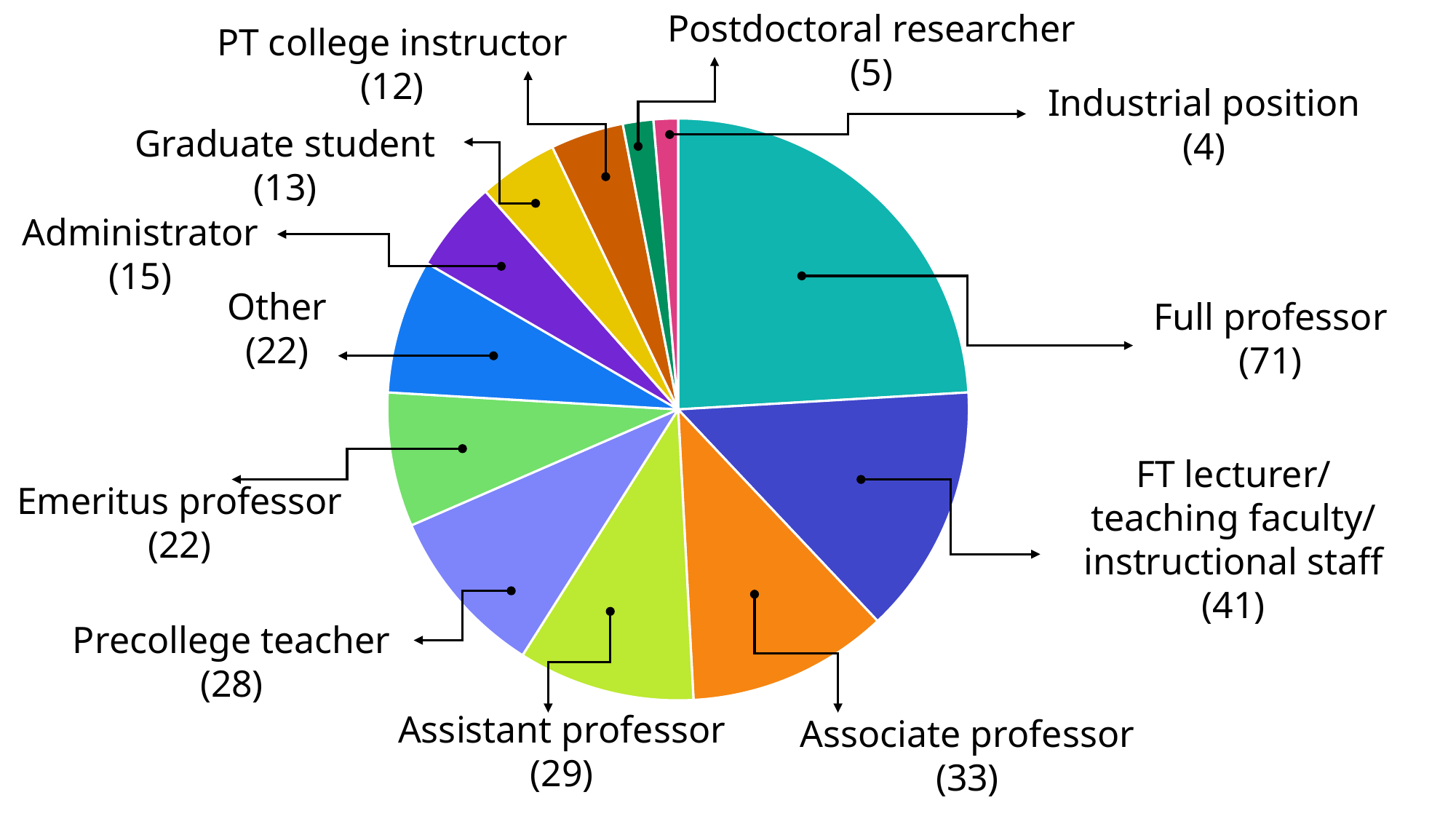
What is the value for Emeritus professor? 22 What is the difference between the Assistant professor value and the Precollege teacher value? 1 Which category has the largest slice of the pie? Full professor Which is larger, the value for Administrator or the value for Graduate student? Administrator What is the value for Precollege teacher? 28 How many respondents are Full professors? 71 What kind of chart is shown on the slide? pie chart What is the value for FT lecturer/teaching faculty/instructional staff? 41 How many categories (slices) does the pie chart have? 12 What is the difference between the Full professor value and the Associate professor value? 38 Which category has the smallest slice of the pie? Industrial position Which is larger, the value for Postdoctoral researcher or the value for PT college instructor? PT college instructor